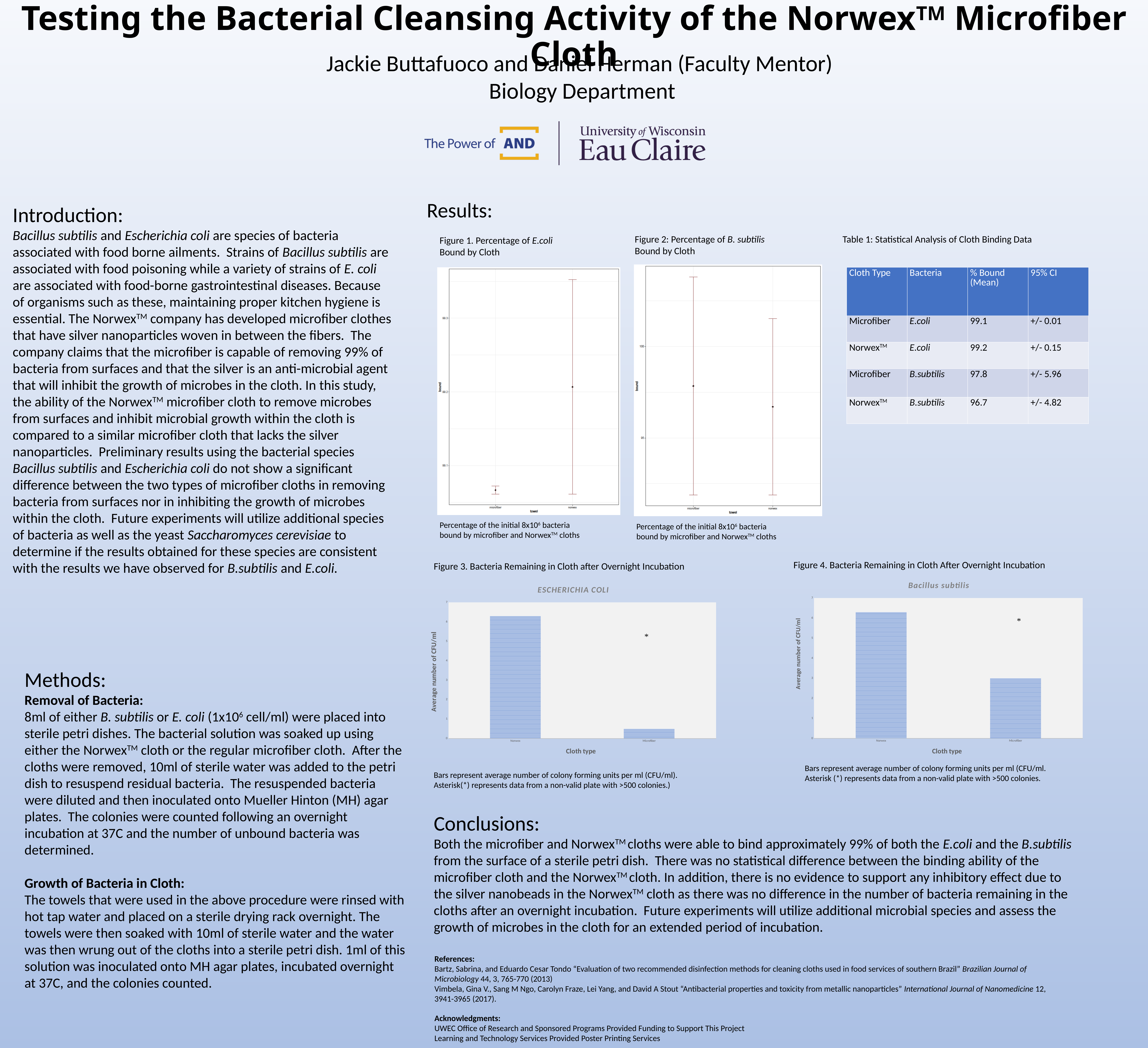
What kind of chart is Figure 3 (Escherichia coli)? Bar chart How many cloth types are plotted in Figure 4 (Bacillus subtilis)? 2 In Figure 3 (Escherichia coli), is the bar for Norwex larger or smaller than the bar for Microfiber? larger In Figure 3 (Escherichia coli), which cloth type has the higher average number of CFU/ml? Norwex In Figure 4 (Bacillus subtilis), which cloth type has the lower average number of CFU/ml? Microfiber What is the x-axis label of Figure 3 (Escherichia coli)? Cloth type How many cloth types are plotted in Figure 3 (Escherichia coli)? 2 In Figure 4 (Bacillus subtilis), is the bar for Microfiber larger or smaller than the bar for Norwex? smaller What is the y-axis label of Figure 4 (Bacillus subtilis)? Average number of CFU/ml In Figure 3 (Escherichia coli), which cloth type has the lower average number of CFU/ml? Microfiber In Figure 4 (Bacillus subtilis), which cloth type has the higher average number of CFU/ml? Norwex What kind of chart is Figure 4 (Bacillus subtilis)? Bar chart